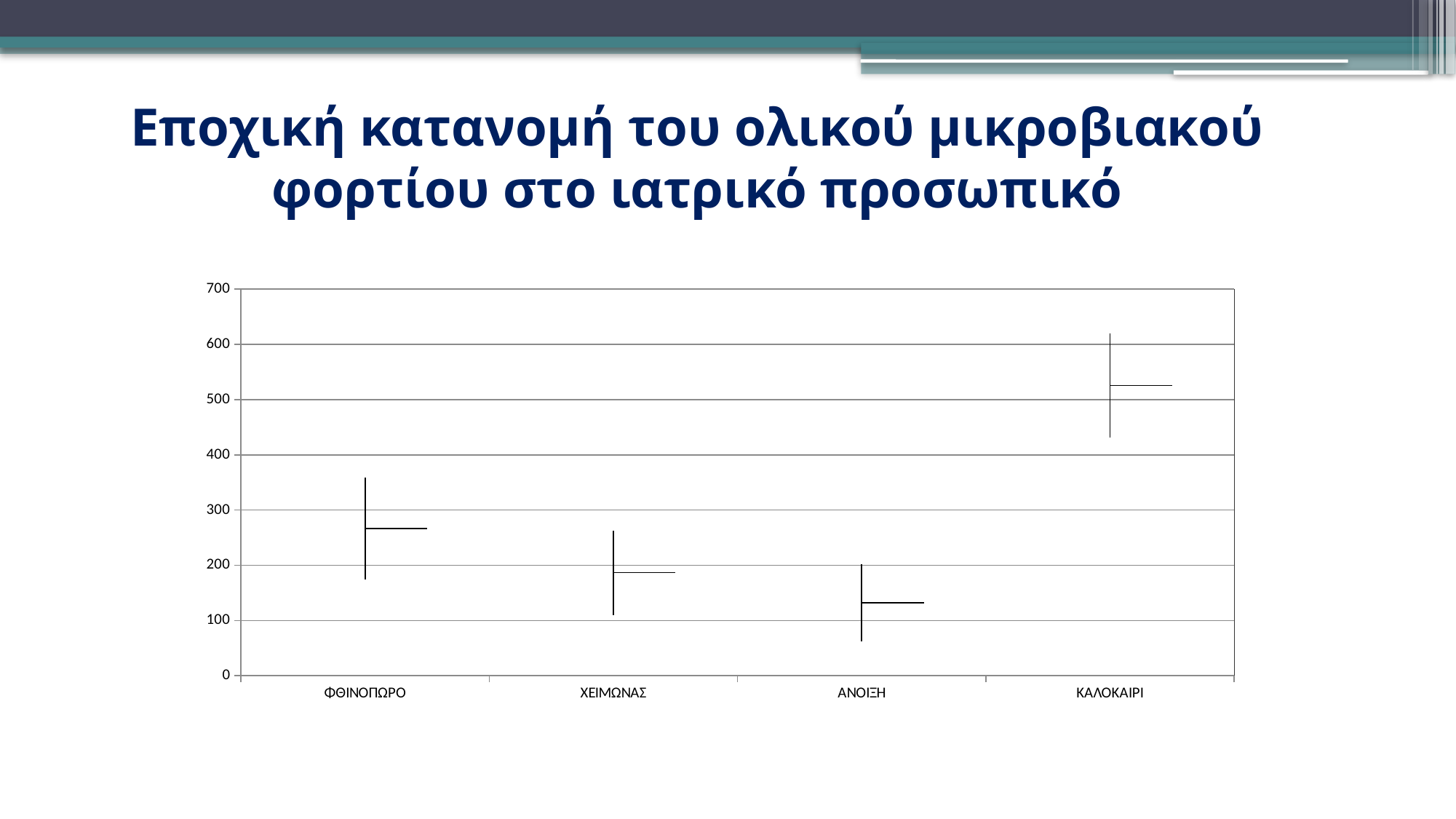
What is the maximum value shown on the y axis of the chart? 700 What is the title of the slide containing the chart? Εποχική κατανομή του ολικού μικροβιακού φορτίου στο ιατρικό προσωπικό Do the values rise or fall from ΦΘΙΝΟΠΩΡΟ to ΑΝΟΙΞΗ? fall Which is larger, the value for ΦΘΙΝΟΠΩΡΟ or the value for ΧΕΙΜΩΝΑΣ? ΦΘΙΝΟΠΩΡΟ Is the value for ΧΕΙΜΩΝΑΣ greater or less than 100? greater Which is larger, the value for ΑΝΟΙΞΗ or the value for ΚΑΛΟΚΑΙΡΙ? ΚΑΛΟΚΑΙΡΙ Which category has the lowest value on the chart? ΑΝΟΙΞΗ Which category has the highest value on the chart? ΚΑΛΟΚΑΙΡΙ How many categories are shown on the x axis of the chart? 4